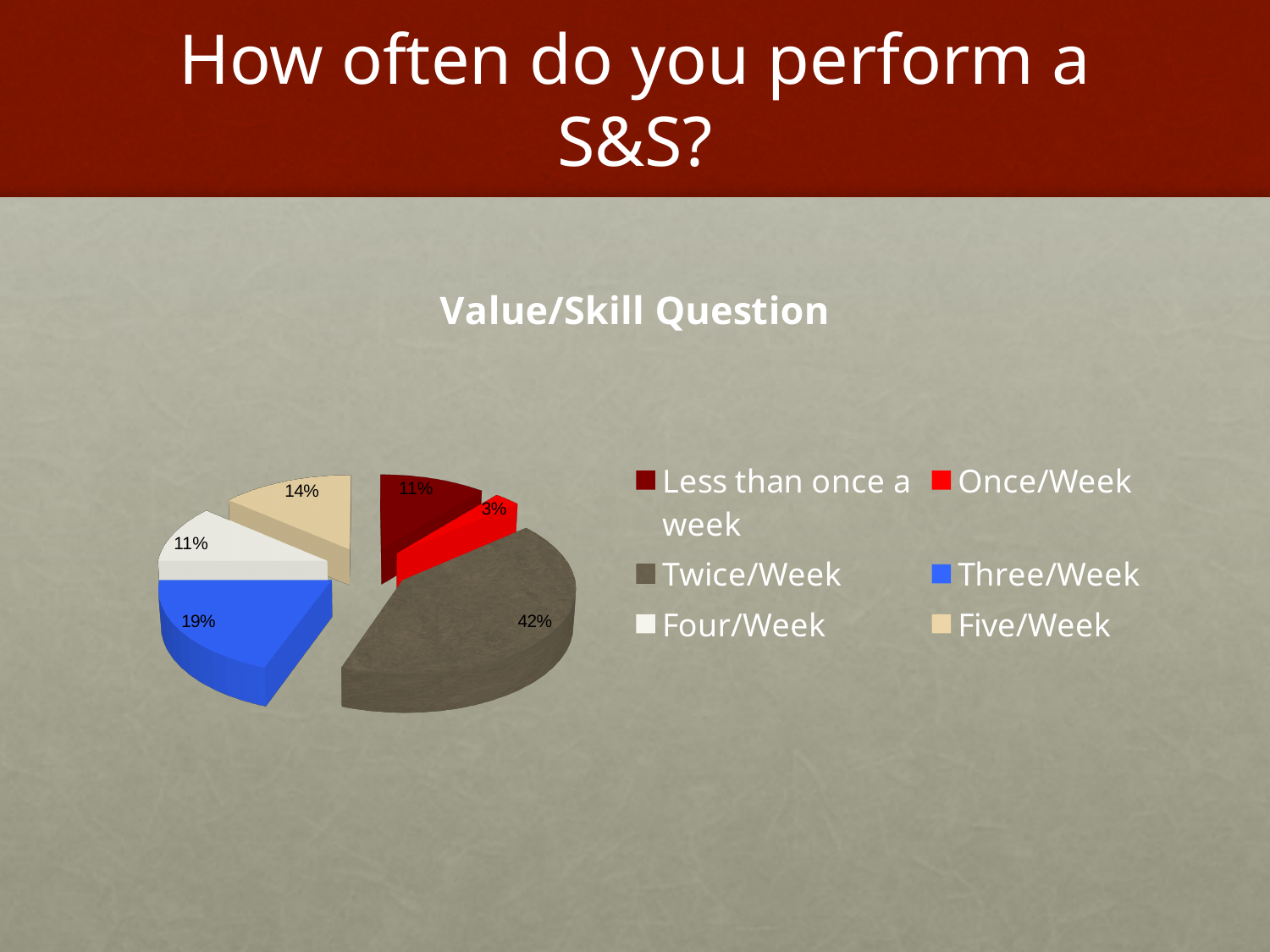
What is the chart's title? Value/Skill Question Which category has the largest slice of the pie? Twice/Week What share of the pie is Three/Week? 19% What share of the pie is Once/Week? 3% What kind of chart is shown on the slide? Pie chart Which category has the smallest slice of the pie? Once/Week What is the difference between the Twice/Week and Three/Week shares? 23% Which is larger, the Five/Week share or the Four/Week share? Five/Week What share of the pie is Five/Week? 14% What colour is the Three/Week slice? Blue How many categories does the legend list? 6